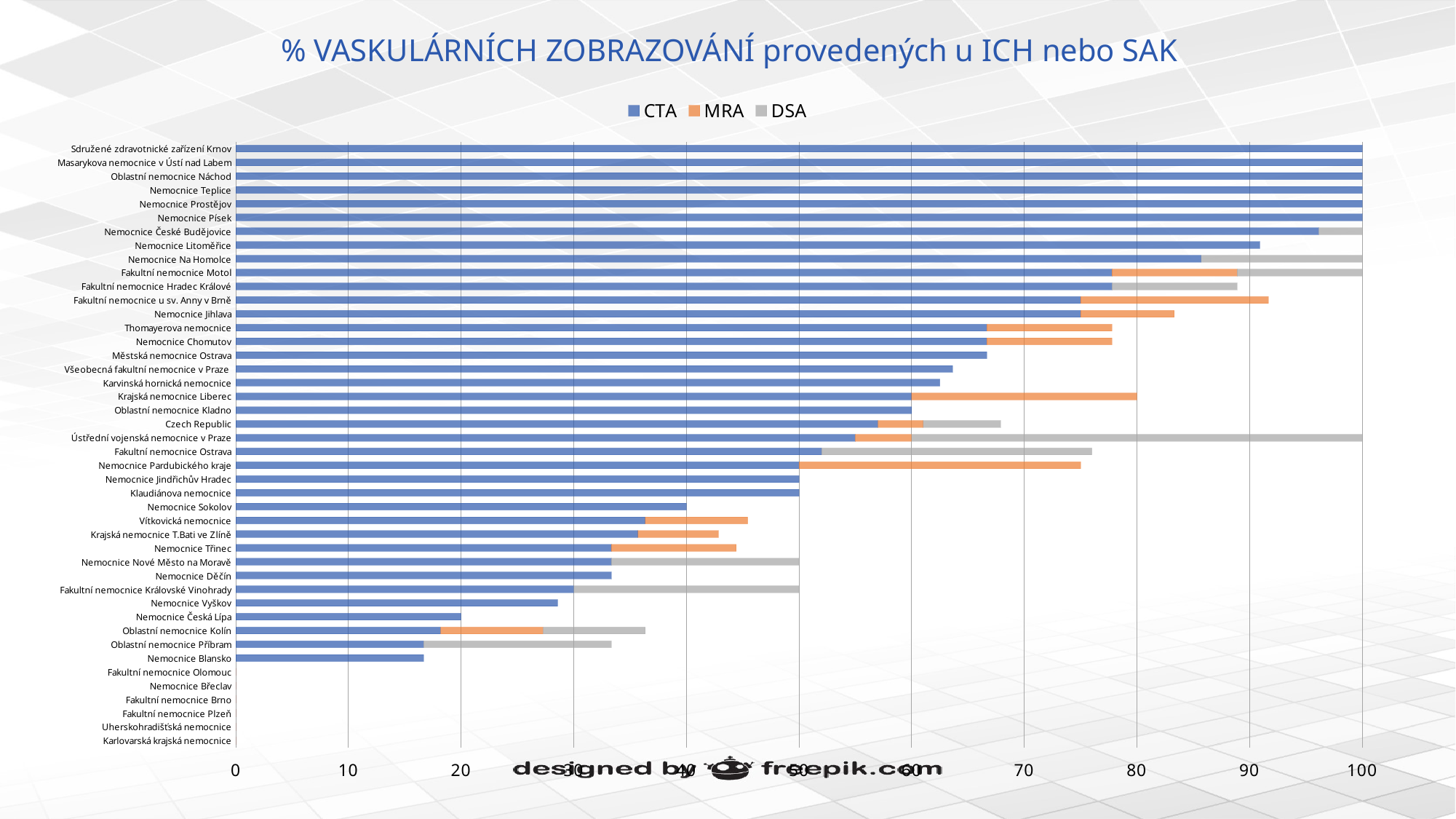
What is the title of the chart? % VASKULÁRNÍCH ZOBRAZOVÁNÍ provedených u ICH nebo SAK What kind of chart is shown on the slide? bar chart Is the CTA value for Nemocnice Blansko greater or less than 20? less Which has the larger CTA value, Nemocnice Litoměřice or Nemocnice Na Homolce? Nemocnice Litoměřice What is the CTA value for Sdružené zdravotnické zařízení Krnov? 100 Is the MRA value for Fakultní nemocnice u sv. Anny v Brně greater or less than 90? less What are the series names listed in the legend? CTA, MRA, DSA What is the CTA value for Nemocnice Česká Lípa? 20 What is the CTA value for Nemocnice Sokolov? 40 How many series does the legend list? 3 Is the MRA value for Oblastní nemocnice Kolín greater or less than 30? less What is the DSA value for Ústřední vojenská nemocnice v Praze? 40